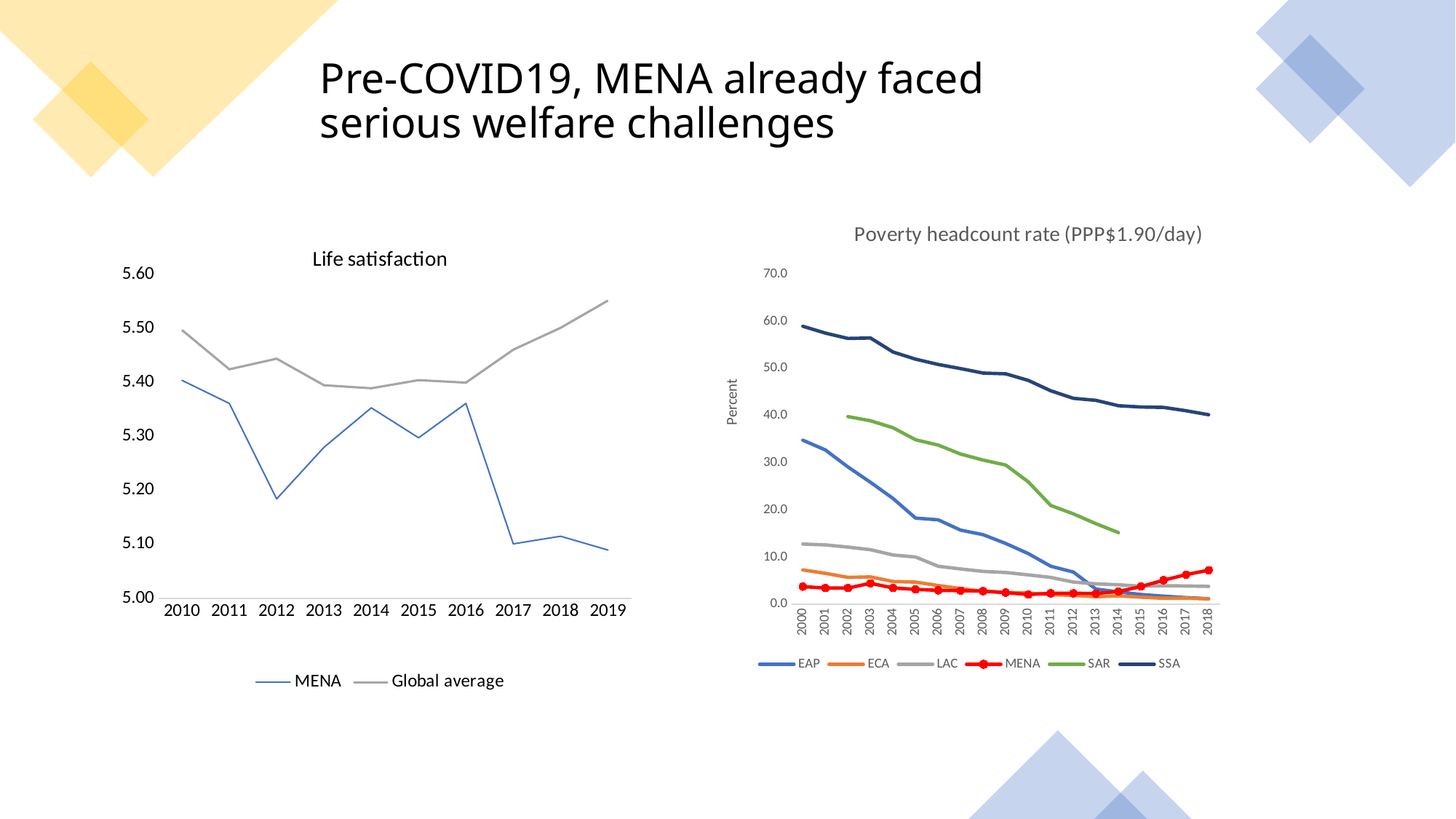
In the Life satisfaction chart, which series is higher in 2019, MENA or Global average? Global average In the Poverty headcount rate chart, which series has the highest value in 2018? SSA In the Poverty headcount rate chart, which series is higher in 2010, SAR or EAP? SAR How many series does the legend of the Poverty headcount rate chart list? 6 In the Poverty headcount rate chart, is the EAP value for 2000 greater or less than 30.0? greater How many years are shown on the x axis of the Life satisfaction chart? 10 In the Life satisfaction chart, does the MENA line overall rise or fall from 2010 to 2019? fall In the Life satisfaction chart, is the Global average value for 2019 greater or less than 5.50? greater What type of chart is the Life satisfaction chart? line chart How many series does the legend of the Life satisfaction chart list? 2 What is the label on the vertical axis of the Poverty headcount rate chart? Percent In the Life satisfaction chart, is the MENA value for 2012 greater or less than 5.20? less